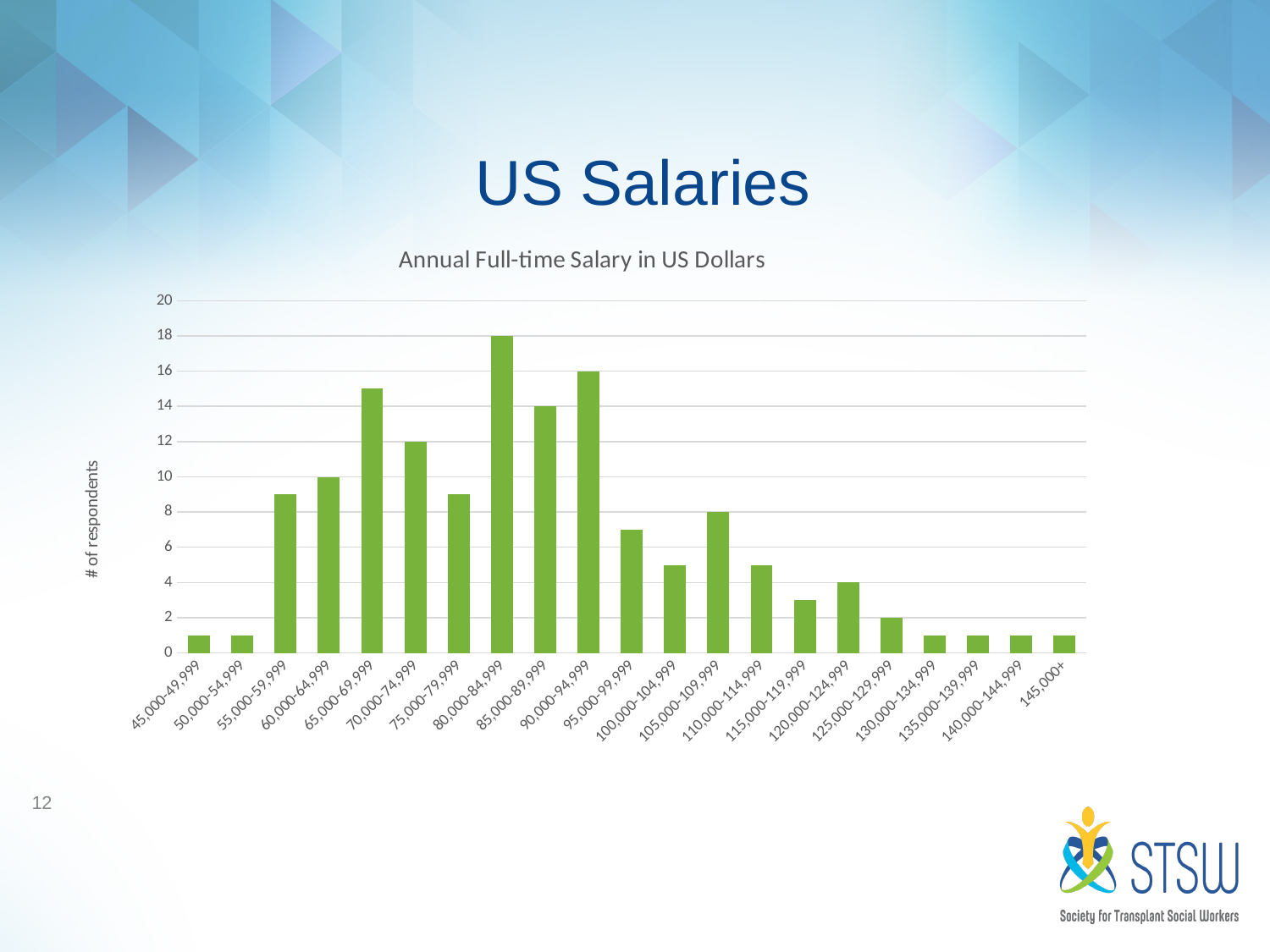
Which salary range has the highest number of respondents? 80,000-84,999 Is the number of respondents for the 95,000-99,999 range greater or less than 8? less What kind of chart is shown on the slide? bar chart What is the difference in respondents between the 80,000-84,999 and 90,000-94,999 ranges? 2 How many respondents are in the 70,000-74,999 salary range? 12 Which has more respondents, the 65,000-69,999 range or the 70,000-74,999 range? 65,000-69,999 How many respondents are in the 80,000-84,999 salary range? 18 How many salary ranges are shown on the x axis? 21 How many respondents are in the 90,000-94,999 salary range? 16 Do the values rise or fall from the 45,000-49,999 range to the 65,000-69,999 range? rise What is the title of the chart? Annual Full-time Salary in US Dollars What is the label on the vertical axis of the chart? # of respondents